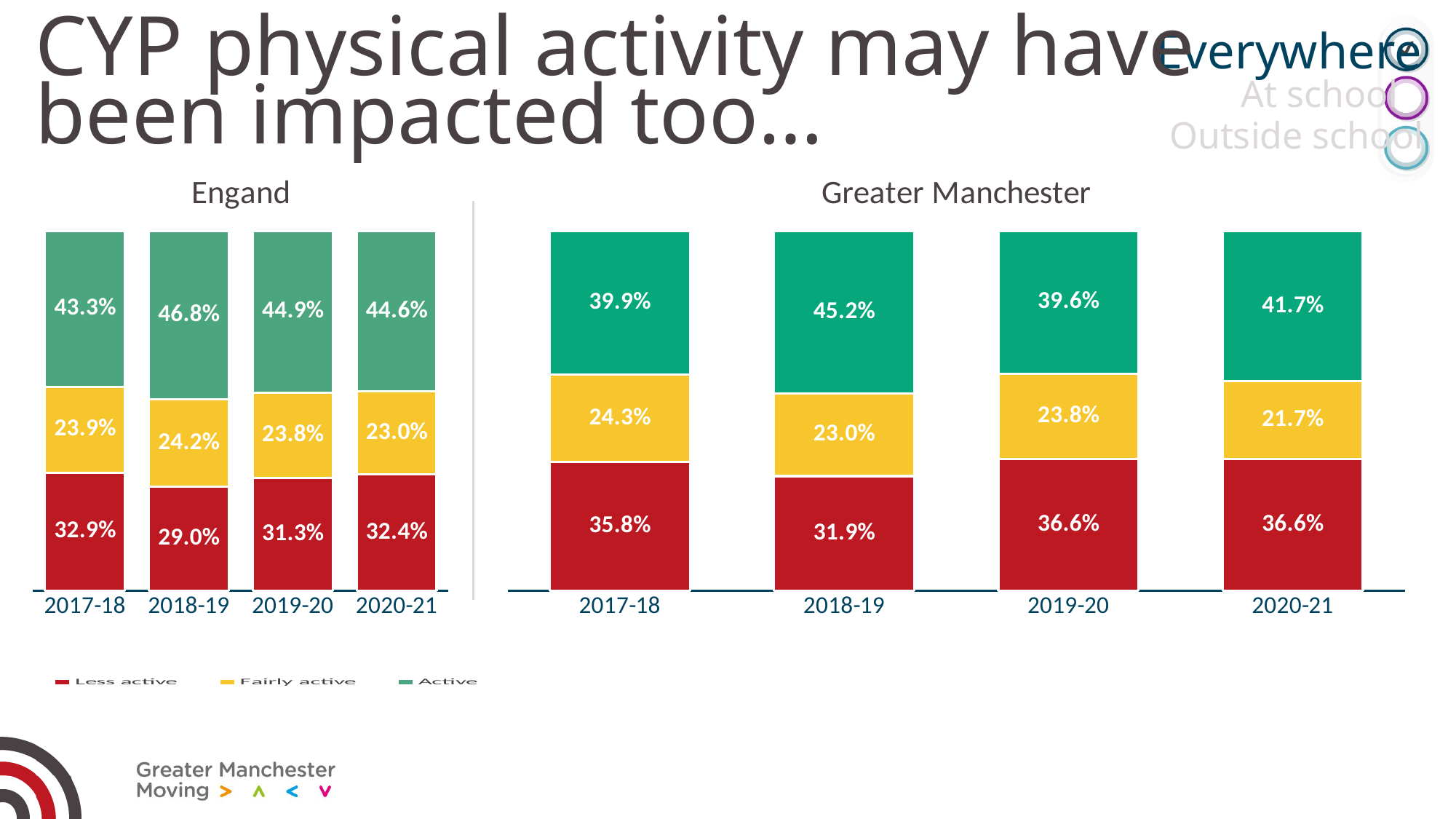
How many series does the legend list? 3 In the Greater Manchester chart, does the Less active value rise or fall from 2018-19 to 2019-20? Rise What kind of chart is the Engand chart? Stacked bar chart In the Greater Manchester chart, which is larger, the Active value for 2018-19 or the Active value for 2019-20? 2018-19 In the Engand chart, what is the Active value for 2018-19? 46.8% In the Engand chart, which year has the highest Active value? 2018-19 In the Greater Manchester chart, what is the Fairly active value for 2020-21? 21.7% Which colour represents the Fairly active series in the legend? Yellow In the Engand chart, what is the difference between the Less active values for 2017-18 and 2018-19? 3.9% In the Greater Manchester chart, what is the Less active value for 2017-18? 35.8% In the Greater Manchester chart, which year has the lowest Less active value? 2018-19 How many years are shown on the x axis of the Greater Manchester chart? 4